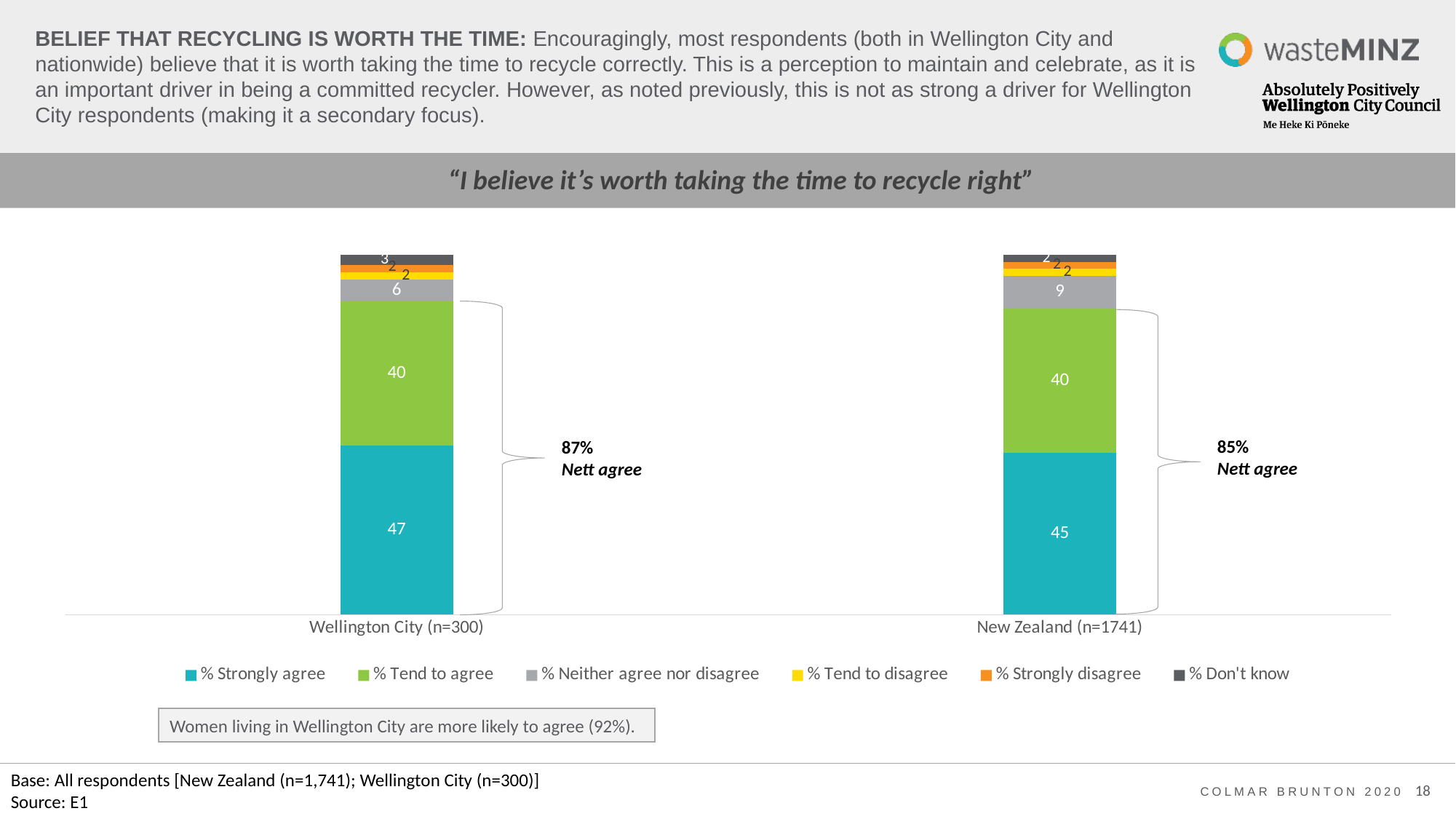
Which has the larger % Strongly agree value, Wellington City or New Zealand? Wellington City What percentage of Wellington City respondents strongly agree that it's worth taking the time to recycle right? 47 How many series does the legend list? 6 How many categories are shown on the x axis? 2 What is the % Neither agree nor disagree value for New Zealand (n=1741)? 9 What percentage of New Zealand respondents strongly agree? 45 What is the difference between the % Strongly agree values for Wellington City and New Zealand? 2 What is the Nett agree figure shown for New Zealand? 85% What is the % Neither agree nor disagree value for Wellington City (n=300)? 6 What is the % Tend to agree value for New Zealand (n=1741)? 40 What kind of chart is shown on the slide? Stacked bar chart What is the Nett agree figure shown for Wellington City? 87%